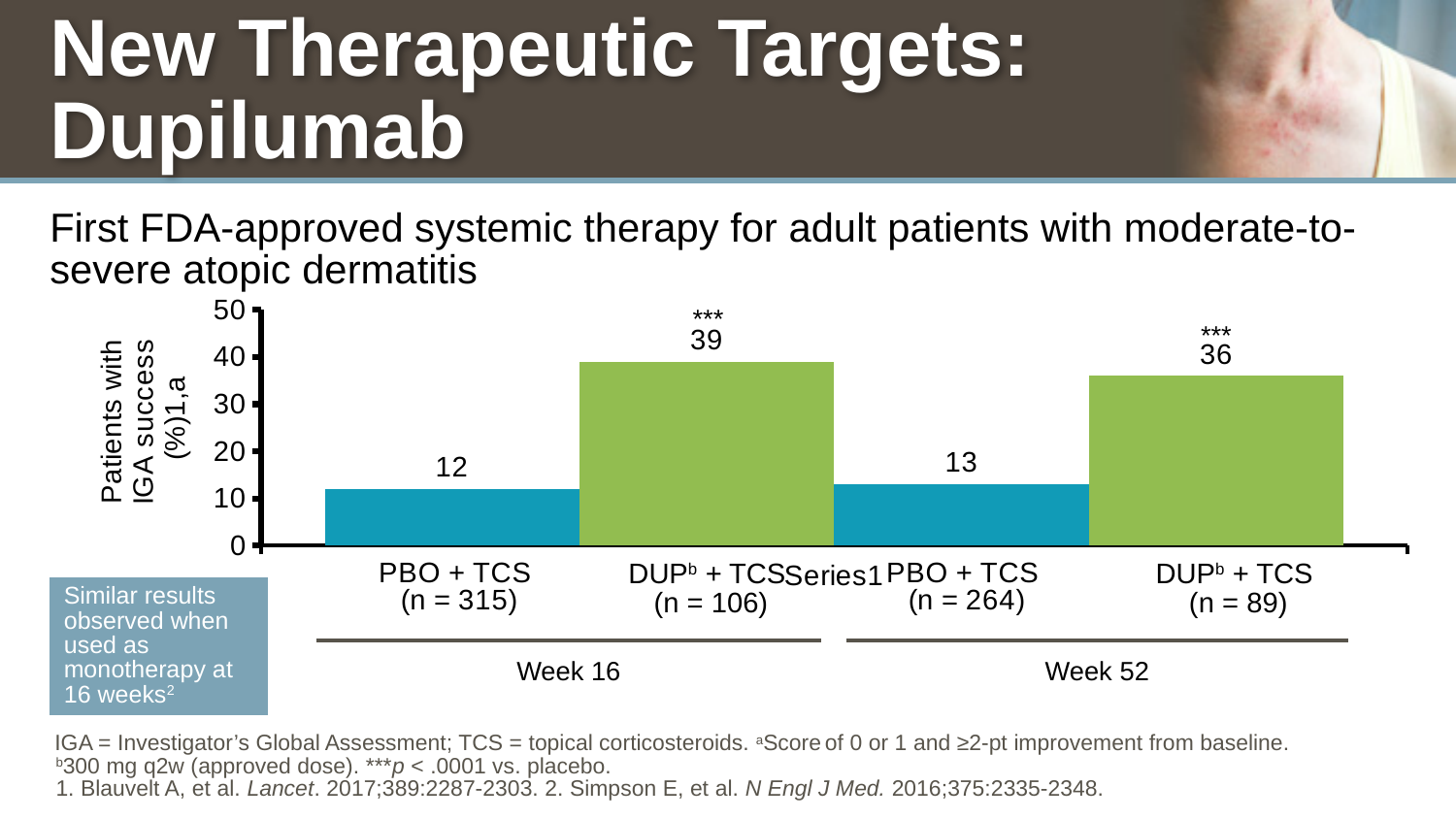
What is the value for PBO + TCS (n = 315) at Week 16? 12 How many bars are plotted in the chart? 4 Which is larger, the DUP + TCS value at Week 16 or the DUP + TCS value at Week 52? DUP + TCS at Week 16 Which bar has the lowest value? PBO + TCS (n = 315) at Week 16 What is the difference between DUP + TCS and PBO + TCS at Week 52? 23 What is the value for DUP + TCS (n = 106) at Week 16? 39 What is the maximum value shown on the y axis? 50 Which bar has the highest value? DUP + TCS (n = 106) at Week 16 What is the value for DUP + TCS (n = 89) at Week 52? 36 What kind of chart is shown on the slide? Bar chart What is the value for PBO + TCS (n = 264) at Week 52? 13 What is the difference between DUP + TCS and PBO + TCS at Week 16? 27